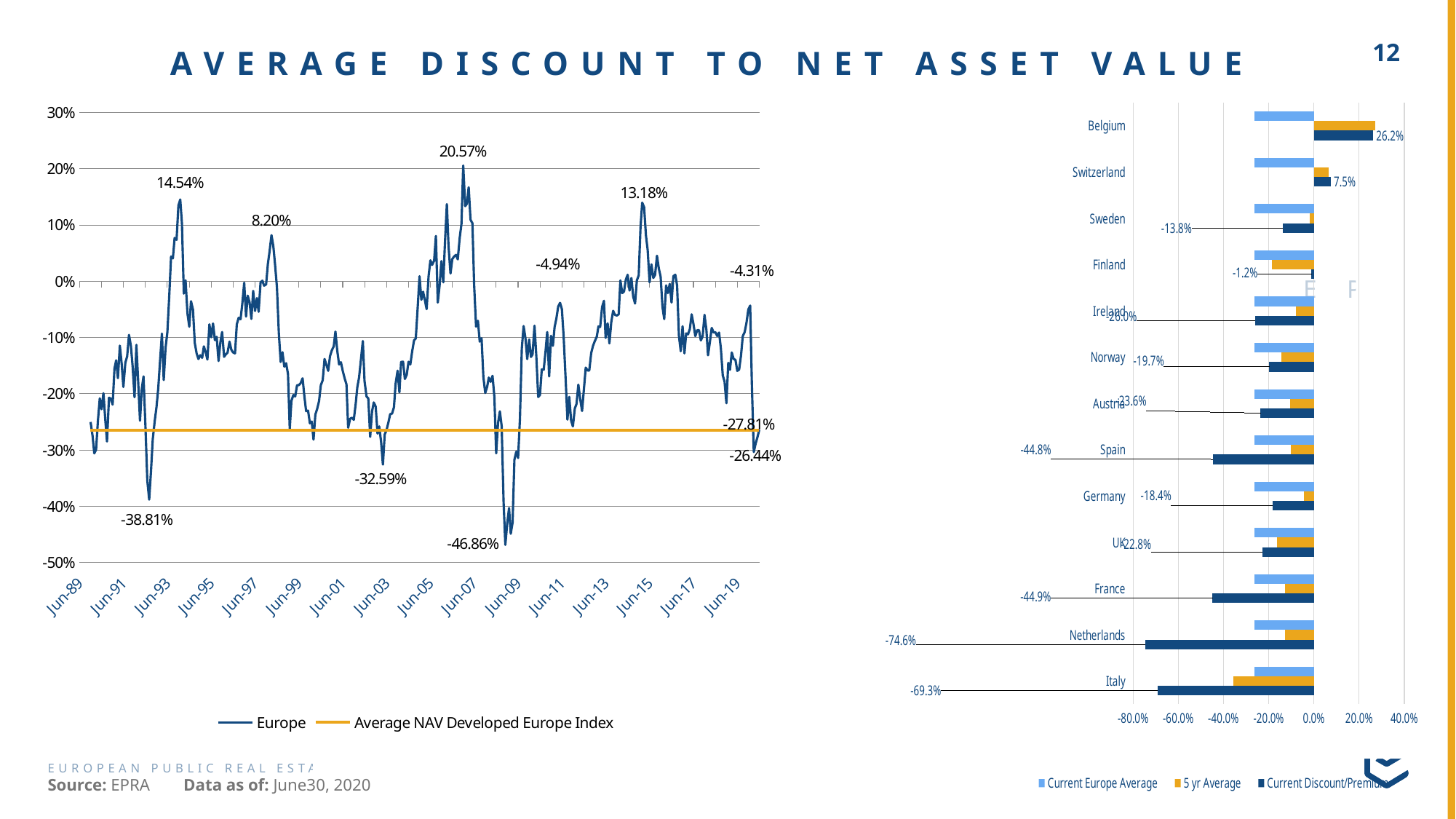
How many series does the legend of the left chart list? 2 On the left chart, what is the last labelled value of the Europe series at the right end of the line? -26.44% On the right chart, what is the Current Discount/Premium value labelled for the Netherlands? -74.6% How many countries are shown on the right chart? 13 On the left chart, what is the lowest labelled value of the Europe series? -46.86% On the right chart, which country has the lowest Current Discount/Premium value? Netherlands On the left chart, what is the highest labelled value of the Europe series? 20.57% On the right chart, what is the difference between the Current Discount/Premium values of Italy (-69.3%) and the Netherlands (-74.6%)? 5.3 percentage points What kind of chart is the chart on the right of the slide? bar chart How many series does the legend of the right chart list? 3 What kind of chart is the chart on the left of the slide? line chart